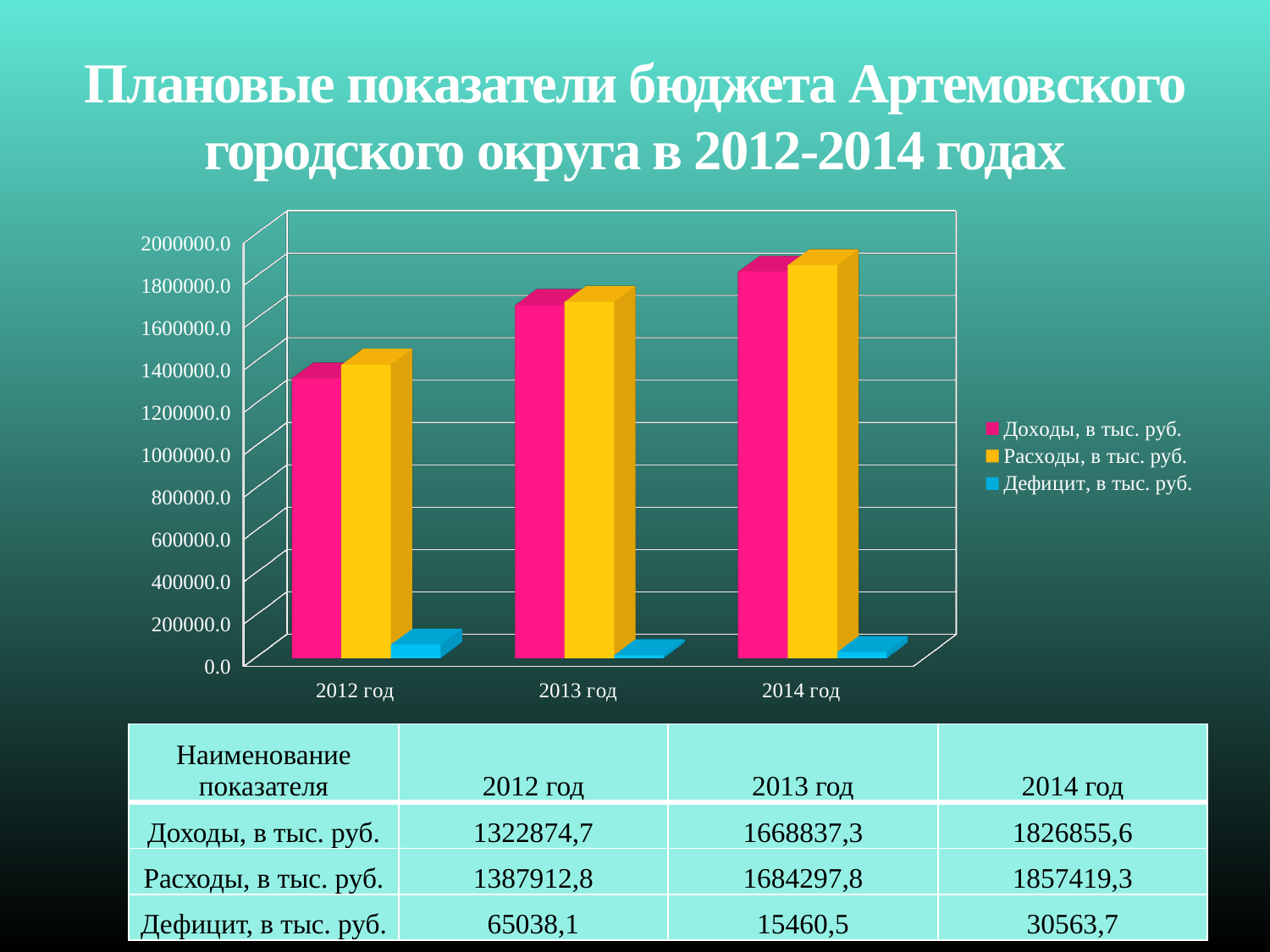
How many years (categories) are shown on the x axis of the chart? 3 In which year is Дефицит, в тыс. руб. the lowest? 2013 год By how much did Доходы, в тыс. руб. increase from 2013 год to 2014 год? 158018,3 What is the difference between Расходы and Доходы in 2012 год? 65038,1 In which year is Доходы, в тыс. руб. the highest? 2014 год What is the value of Доходы, в тыс. руб. for 2012 год? 1322874,7 Do the values of Доходы, в тыс. руб. rise or fall from 2012 год to 2014 год? rise Is the value of Доходы for 2012 год greater or less than 1400000.0? less What is the value of Расходы, в тыс. руб. for 2014 год? 1857419,3 In 2013 год, which is larger: Доходы or Расходы? Расходы How many series does the chart legend list? 3 What is the value of Дефицит, в тыс. руб. for 2013 год? 15460,5